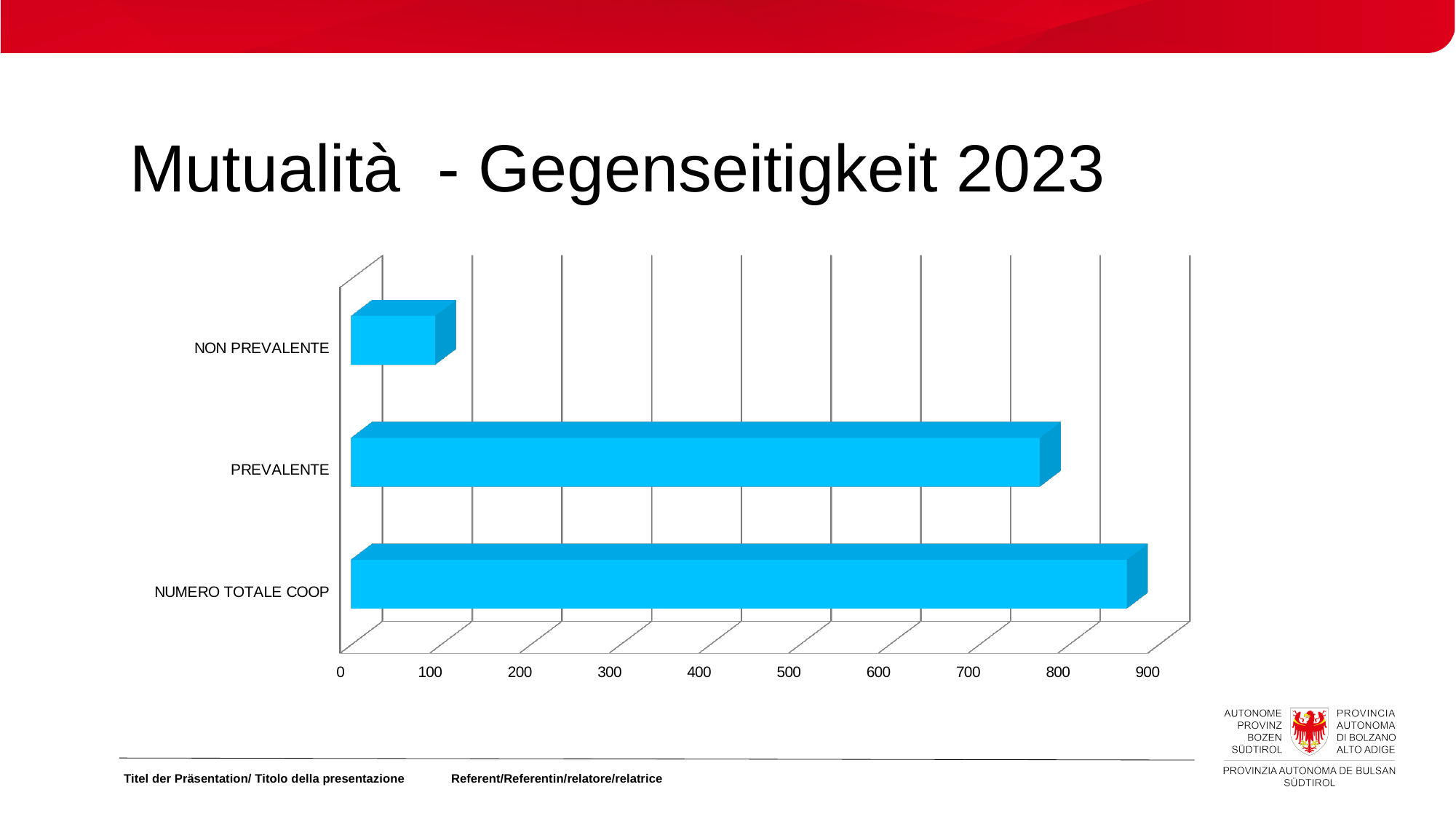
Which category has the highest value? NUMERO TOTALE COOP What is the highest value shown on the horizontal axis? 900 What kind of chart is shown on the slide? bar chart Is the value for NON PREVALENTE greater or less than 200? less How many categories are plotted in the chart? 3 Which is larger, the value for NUMERO TOTALE COOP or the value for PREVALENTE? NUMERO TOTALE COOP Which category has the lowest value? NON PREVALENTE Which is larger, the value for PREVALENTE or the value for NON PREVALENTE? PREVALENTE What is the title of the slide containing the chart? Mutualità - Gegenseitigkeit 2023 Is the value for PREVALENTE greater or less than 700? greater Is the value for PREVALENTE greater or less than 900? less